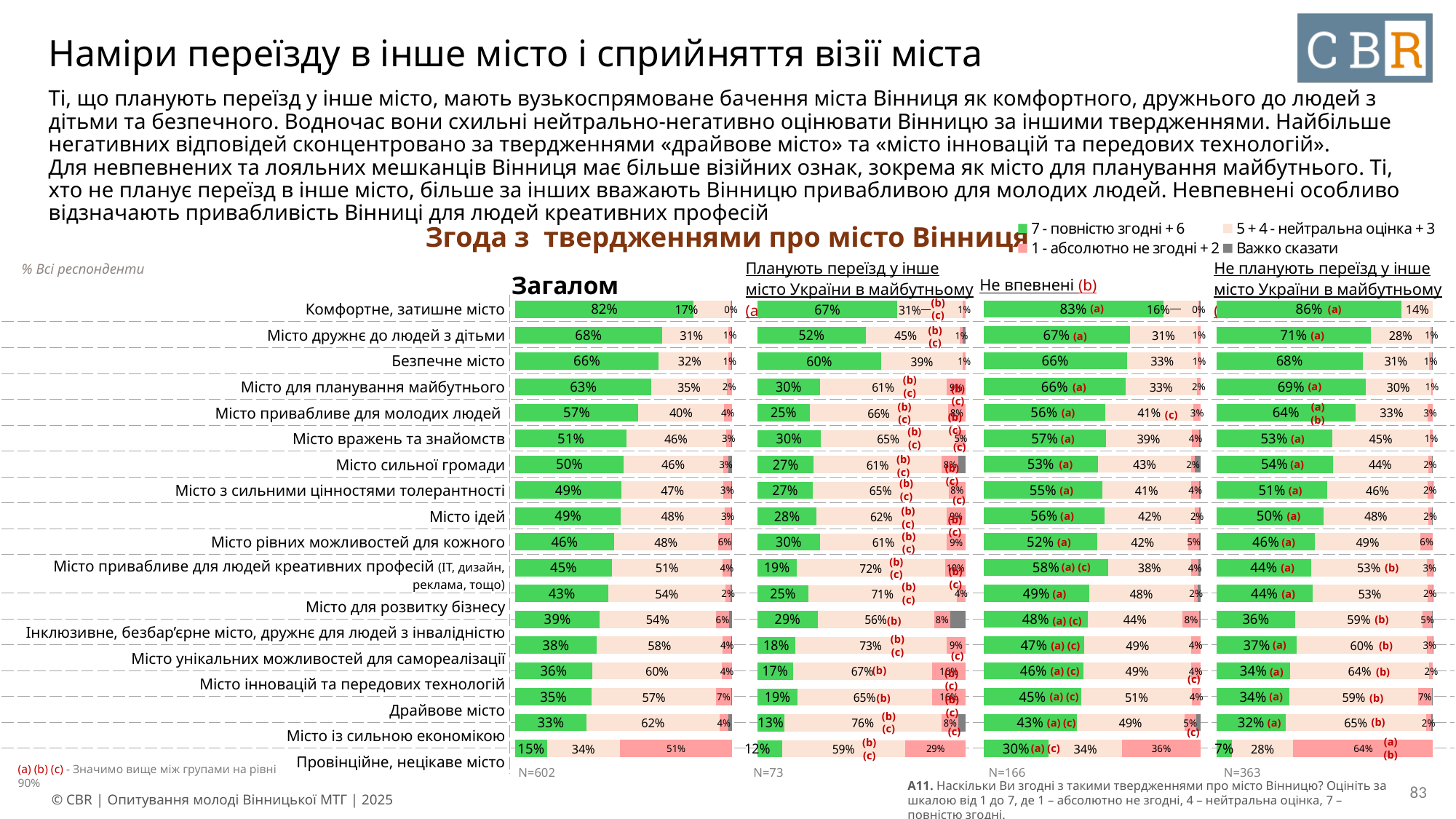
In the 'Загалом' chart, what is the neutral (5 + 4 + 3) share for 'Місто із сильною економікою'? 62% How many statements about the city are shown in the 'Загалом' chart? 18 In the 'Загалом' chart, what percentage fully agree (7 + 6) with 'Комфортне, затишне місто'? 82% In the 'Планують переїзд у інше місто України в майбутньому' chart, what percentage agree (7 + 6) with 'Безпечне місто'? 60% In the 'Не впевнені' chart, what percentage agree (7 + 6) with 'Комфортне, затишне місто'? 83% In the 'Загалом' chart, which statement has the lowest share of respondents who agree (7 + 6)? Провінційне, нецікаве місто In the 'Загалом' chart, which statement has the highest share of respondents who agree (7 + 6)? Комфортне, затишне місто How many series does the legend list for the charts on this slide? 4 In the 'Загалом' chart, what is the difference in the agree (7 + 6) share between 'Комфортне, затишне місто' and 'Безпечне місто'? 16 percentage points In the 'Не планують переїзд у інше місто України в майбутньому' chart, what percentage agree (7 + 6) with 'Комфортне, затишне місто'? 86% What type of chart is used to show agreement with the statements about Vinnytsia? Stacked bar chart In the 'Загалом' chart, which has a higher agree (7 + 6) share: 'Місто ідей' or 'Місто для розвитку бізнесу'? Місто ідей